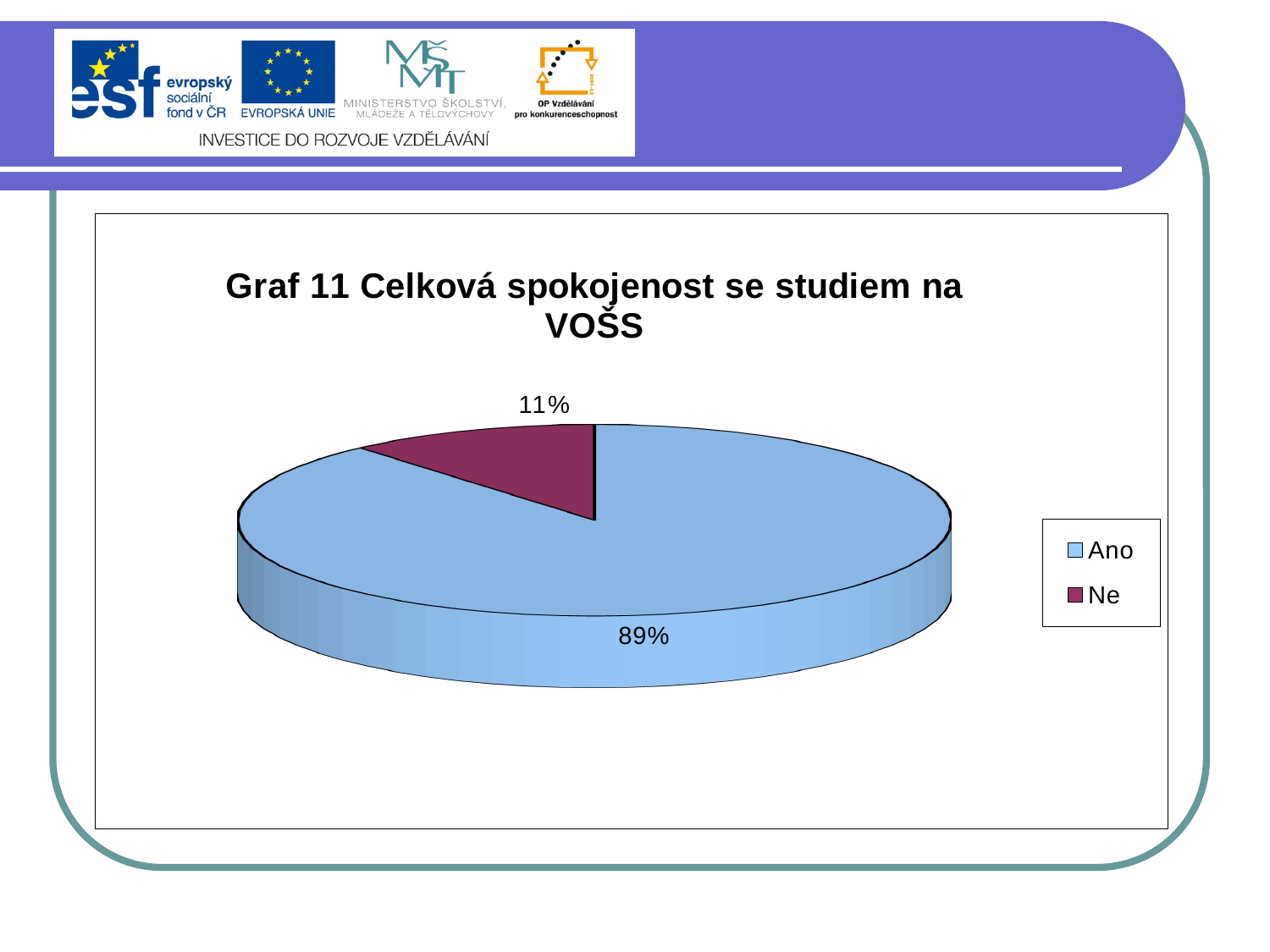
What is the title of the chart? Graf 11 Celková spokojenost se studiem na VOŠS What kind of chart is shown on the slide? pie chart How many categories does the pie chart have? 2 Which category has the largest slice of the pie? Ano How many entries does the legend list? 2 What colour is the "Ne" slice? dark red What is the difference in percentage points between the "Ano" and "Ne" slices? 78 What share of the pie does "Ne" represent? 11% Which is larger, the "Ano" slice or the "Ne" slice? Ano Which category has the smallest slice of the pie? Ne What share of the pie does "Ano" represent? 89%